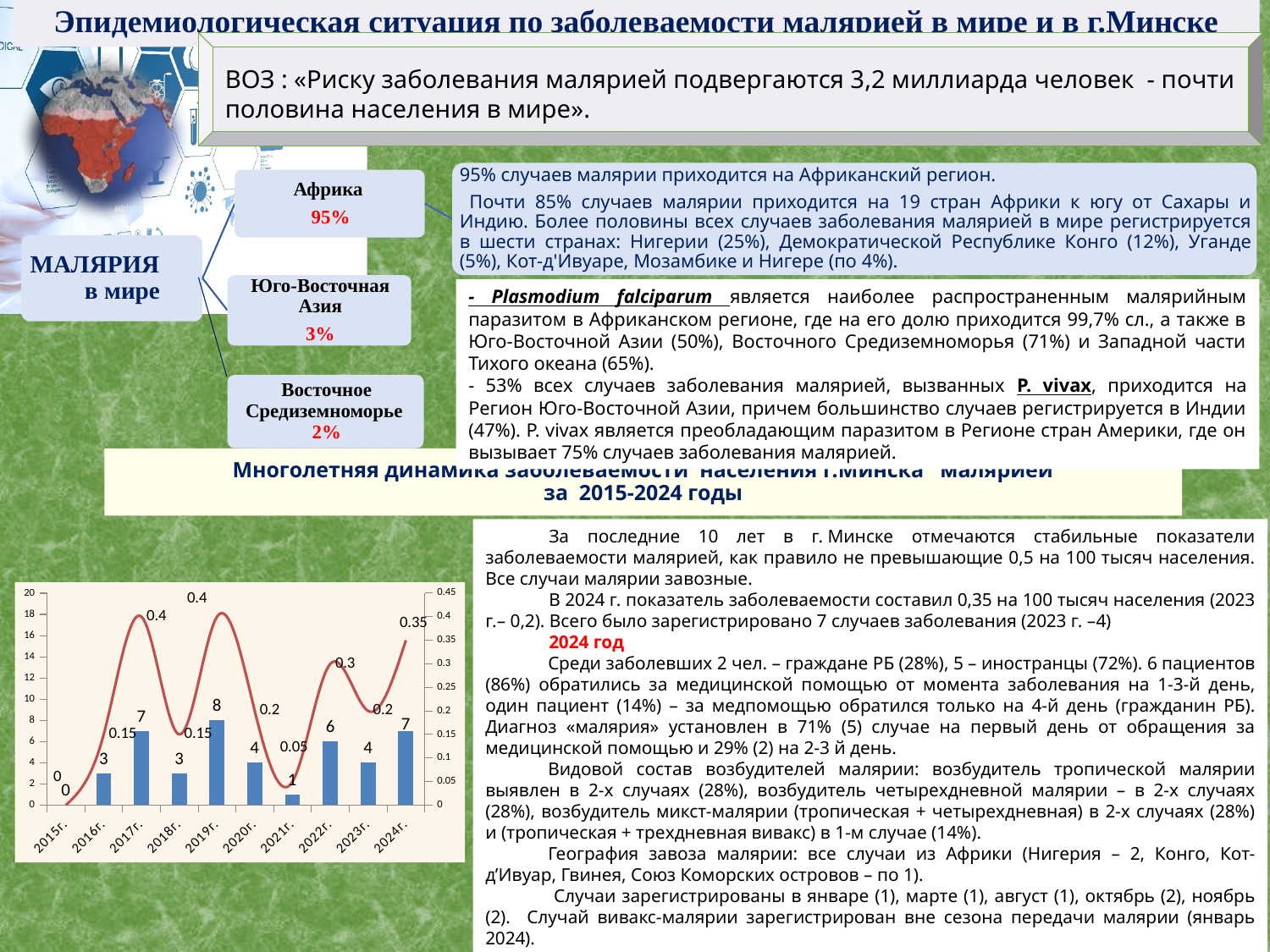
What is the value of the line (incidence rate) for 2024 (2024г.)? 0.35 Which is larger, the bar value for 2017 or for 2022? 2017г. Which year has the lowest bar value? 2015г. What is the bar value for 2021 (2021г.)? 1 Do the bar values rise or fall from 2019 to 2021? fall How many years (categories) are shown on the x axis? 10 What is the difference between the bar values for 2019 and 2021? 7 Which year has the highest bar value? 2019г. Is the bar value for 2019 greater or less than 10 on the left axis? less What is the difference between the line values for 2017 and 2024? 0.05 What is the number of malaria cases shown by the bar for 2019 (2019г.)? 8 What kind of chart is shown on the slide? Bar chart with a line